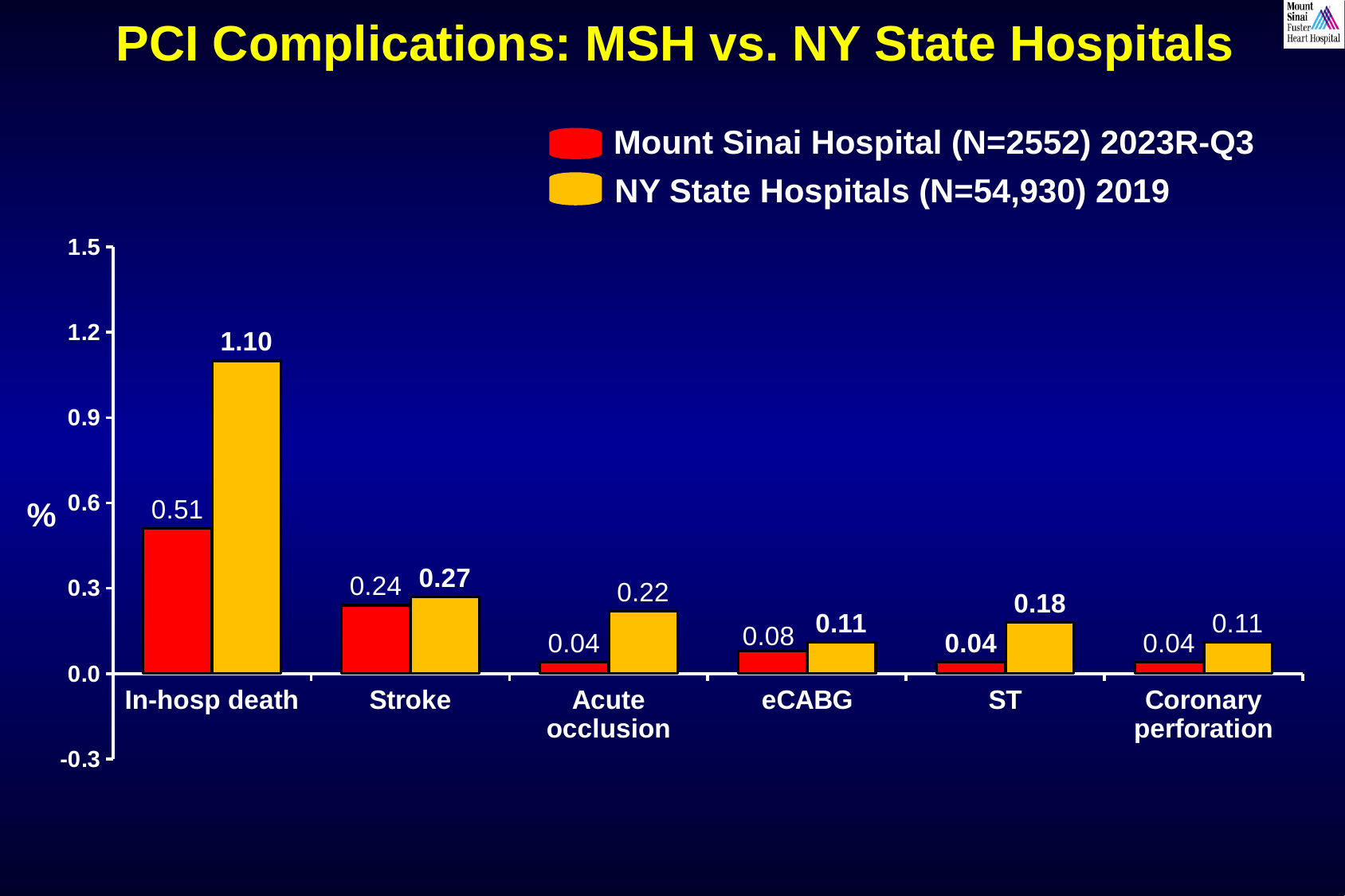
What is the acute occlusion rate for Mount Sinai Hospital? 0.04 Which complication has the highest rate for NY State Hospitals? In-hosp death How many complication categories are shown on the x axis? 6 What is the in-hospital death rate for Mount Sinai Hospital? 0.51 Which complication has the highest rate for Mount Sinai Hospital? In-hosp death Which is larger for acute occlusion: the Mount Sinai Hospital rate or the NY State Hospitals rate? NY State Hospitals What is the in-hospital death rate for NY State Hospitals? 1.10 How many series does the legend list? 2 What is the stroke rate for NY State Hospitals? 0.27 What is the difference between the NY State Hospitals and Mount Sinai Hospital eCABG rates? 0.03 What is the difference between the NY State Hospitals and Mount Sinai Hospital in-hospital death rates? 0.59 What is the ST rate for NY State Hospitals? 0.18